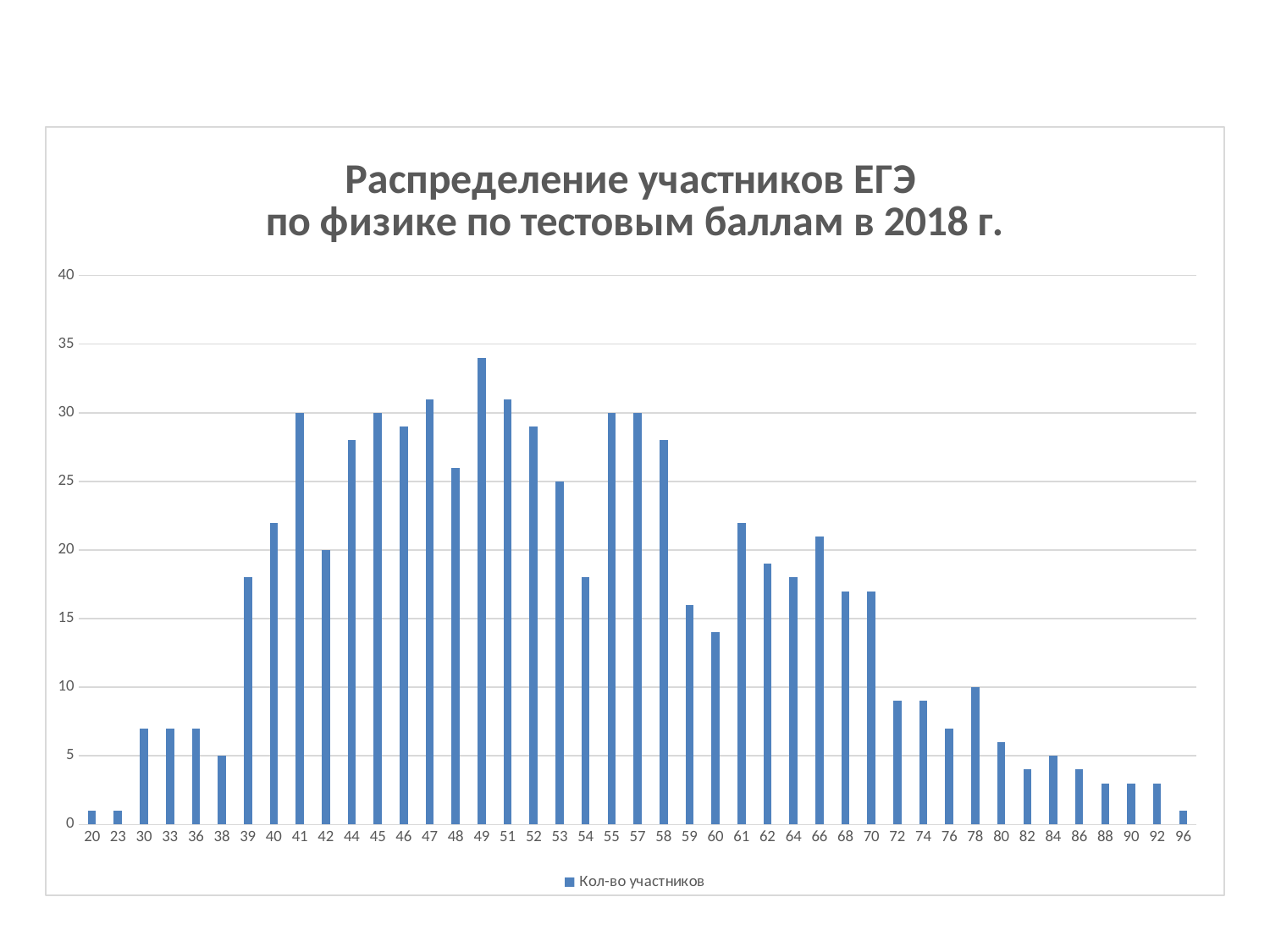
Is the number of participants with 60 points greater or less than 15? less How many participants scored 53 points? 25 Which score has more participants, 40 or 54? 40 How many participants scored 78 points? 10 How many participants scored 42 points? 20 What kind of chart is shown on the slide? Bar chart How many score categories are shown on the x axis? 43 Is the number of participants with 47 points greater or less than 30? greater Which test score has the highest number of participants? 49 How many participants scored 41 points? 30 What is the name of the series in the legend? Кол-во участников What is the difference between the number of participants with 41 points and with 42 points? 10